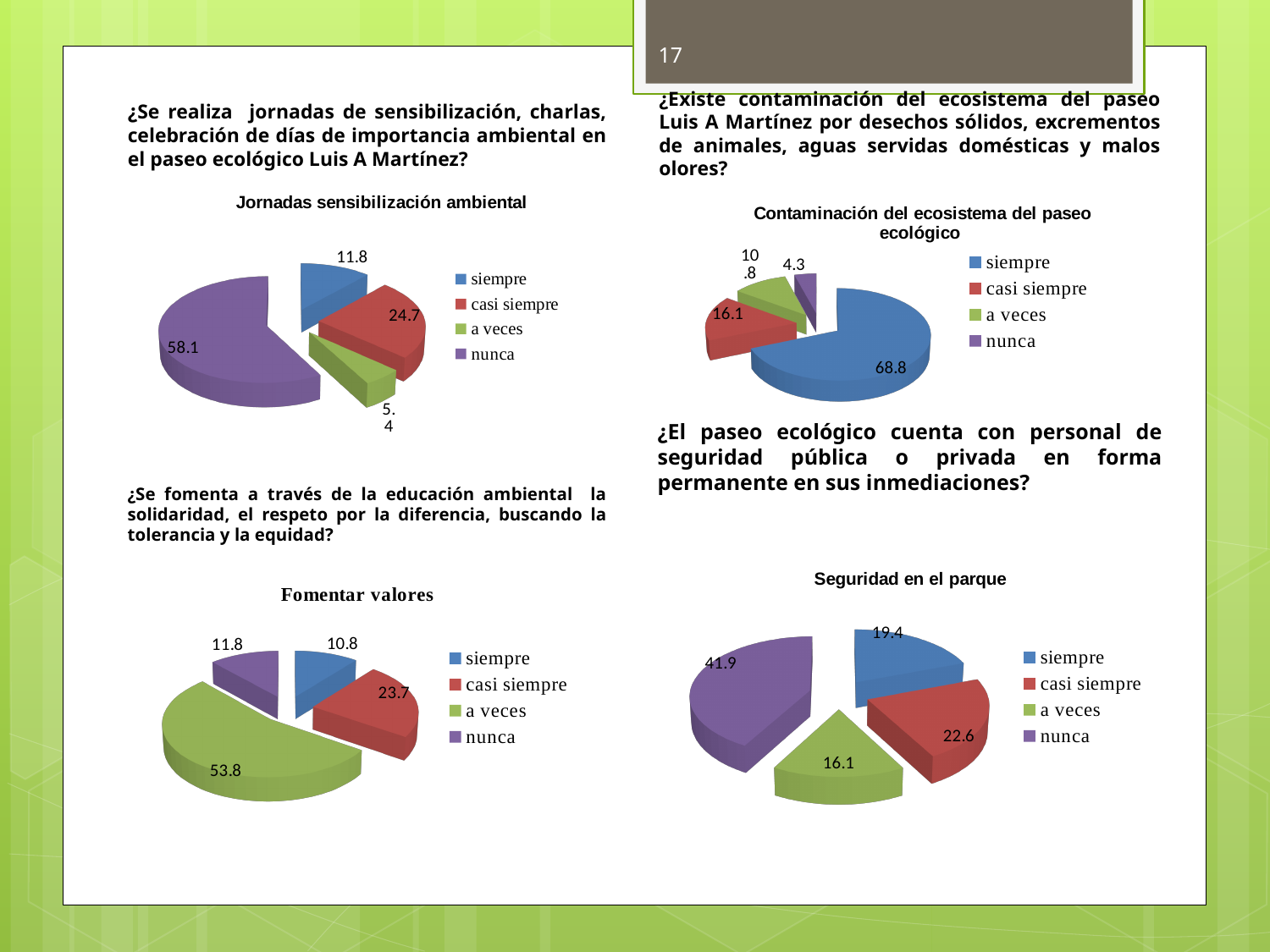
In the 'Contaminación del ecosistema del paseo ecológico' chart, what is the difference between 'casi siempre' and 'nunca'? 11.8 In the 'Jornadas sensibilización ambiental' chart, what is the value for 'nunca'? 58.1 In the 'Jornadas sensibilización ambiental' chart, which category has the smallest slice? a veces How many categories does the legend of the 'Seguridad en el parque' chart list? 4 In the 'Seguridad en el parque' chart, what is the difference between 'nunca' and 'siempre'? 22.5 In the 'Fomentar valores' chart, what is the value for 'a veces'? 53.8 In the 'Seguridad en el parque' chart, which category has the smallest slice? a veces What type of chart is 'Fomentar valores'? Pie chart In the 'Contaminación del ecosistema del paseo ecológico' chart, what is the value for 'siempre'? 68.8 In the 'Fomentar valores' chart, which is larger, 'siempre' or 'casi siempre'? casi siempre In the 'Seguridad en el parque' chart, what is the value for 'nunca'? 41.9 In the 'Contaminación del ecosistema del paseo ecológico' chart, which category has the largest slice? siempre